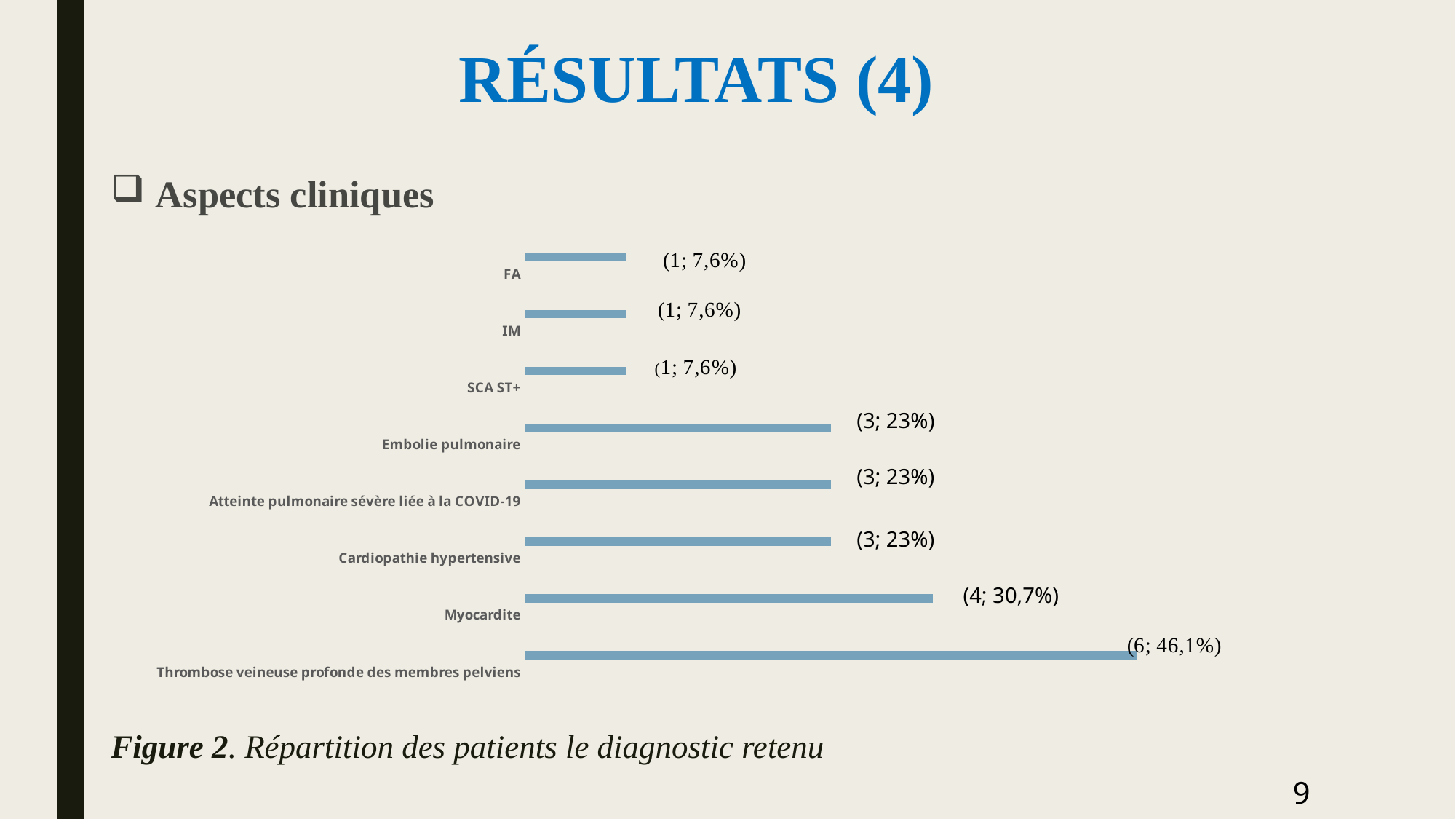
How many diagnoses have a value of 1 patient (7,6%)? 3 What is the caption of the figure shown on the slide? Figure 2. Répartition des patients le diagnostic retenu How many categories (diagnoses) are plotted in the chart? 8 What percentage is shown for Cardiopathie hypertensive? 23% What is the data label shown for Thrombose veineuse profonde des membres pelviens? (6; 46,1%) What is the difference in number of patients between Thrombose veineuse profonde des membres pelviens and Myocardite? 2 What is the data label shown for Myocardite? (4; 30,7%) What kind of chart is shown on the slide? bar chart What percentage is shown for SCA ST+? 7,6% Which is larger, the value for Myocardite or the value for Embolie pulmonaire? Myocardite Which diagnosis has the highest value in the chart? Thrombose veineuse profonde des membres pelviens How many patients are shown for Embolie pulmonaire? 3